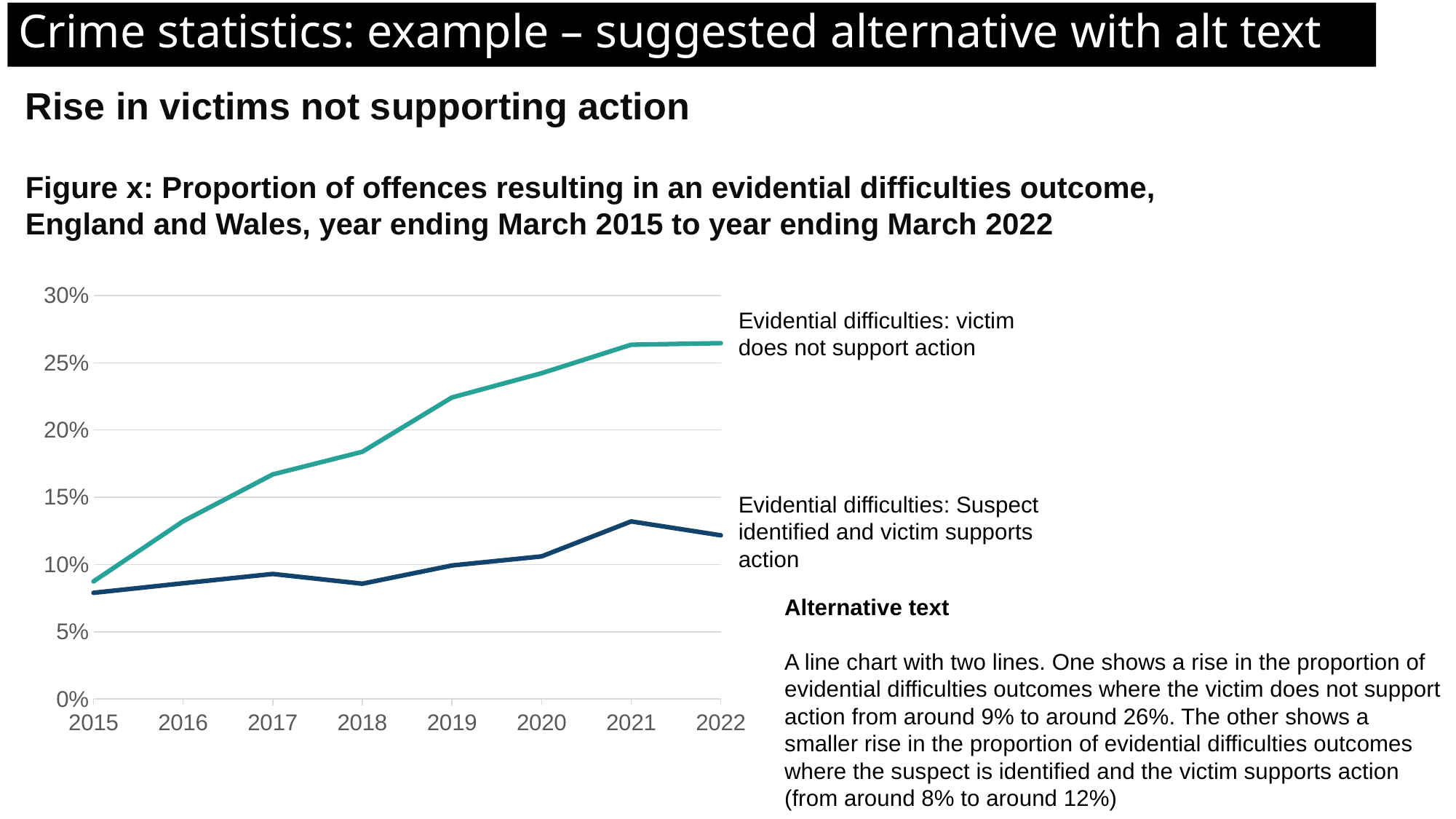
Does the 'Evidential difficulties: victim does not support action' line rise or fall from 2015 to 2022? rise Is the value for 'Evidential difficulties: Suspect identified and victim supports action' in 2015 greater or less than 10%? less Is the value for 'Evidential difficulties: victim does not support action' in 2015 greater or less than 10%? less Is the value for 'Evidential difficulties: victim does not support action' in 2022 greater or less than 25%? greater In 2022, which series has the larger value: 'victim does not support action' or 'Suspect identified and victim supports action'? victim does not support action What kind of chart is shown on the slide? line chart How many years are plotted along the x axis? 8 In which year is the 'Evidential difficulties: victim does not support action' line at its lowest? 2015 How many series are plotted on the chart? 2 In which year is the 'Evidential difficulties: Suspect identified and victim supports action' line at its highest? 2021